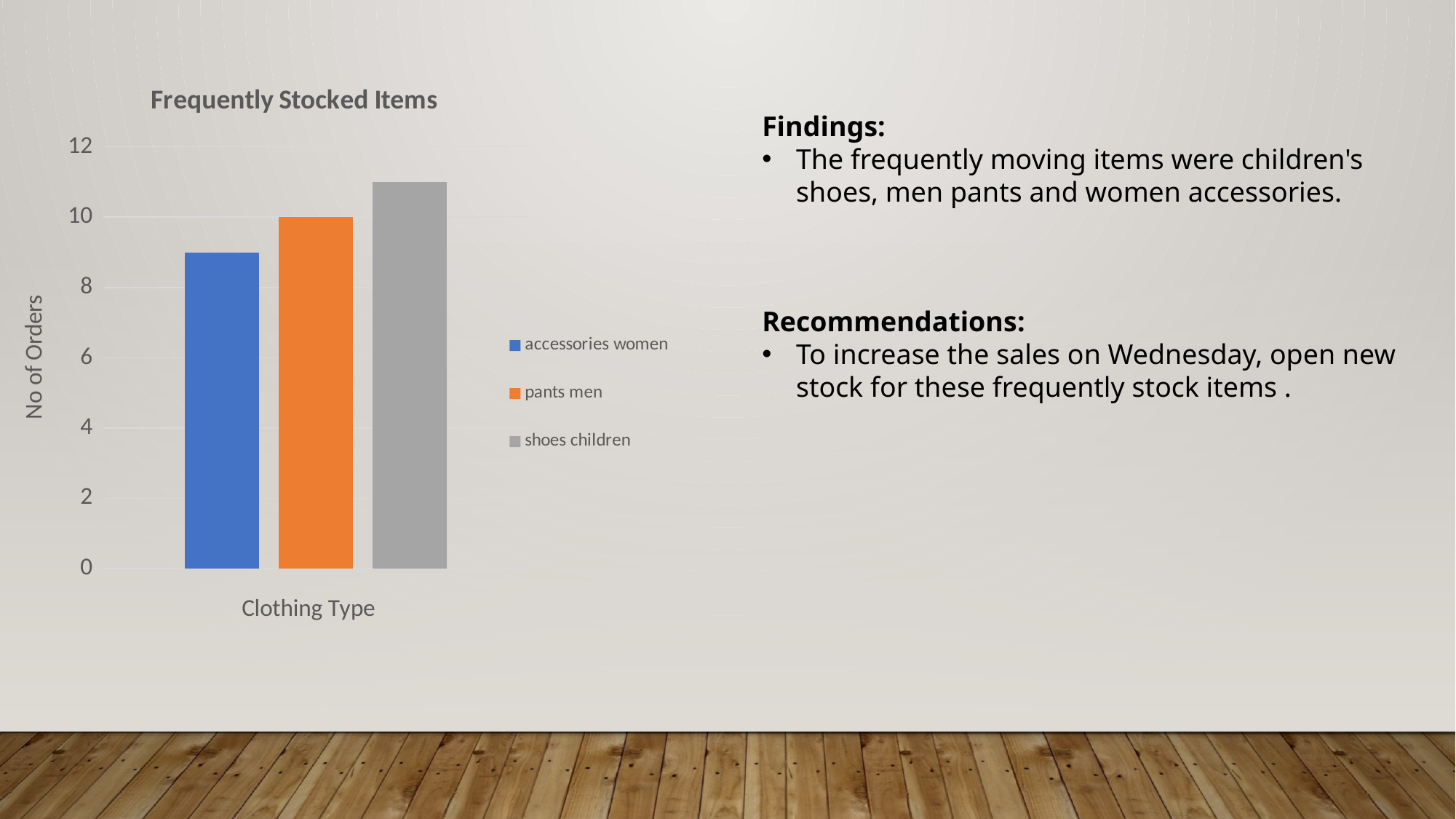
Is the value for accessories women greater or less than 10? less Is the value for shoes children greater or less than 12? less What type of chart is shown on the slide? bar chart Is the value for accessories women greater or less than 8? greater Which is larger, the value for accessories women or the value for pants men? pants men What is the label on the vertical axis of the chart? No of Orders Which series has the lowest number of orders? accessories women How many series does the chart legend list? 3 Which is larger, the value for shoes children or the value for pants men? shoes children What is the value for pants men? 10 What is the title of the chart? Frequently Stocked Items Which series has the highest number of orders? shoes children